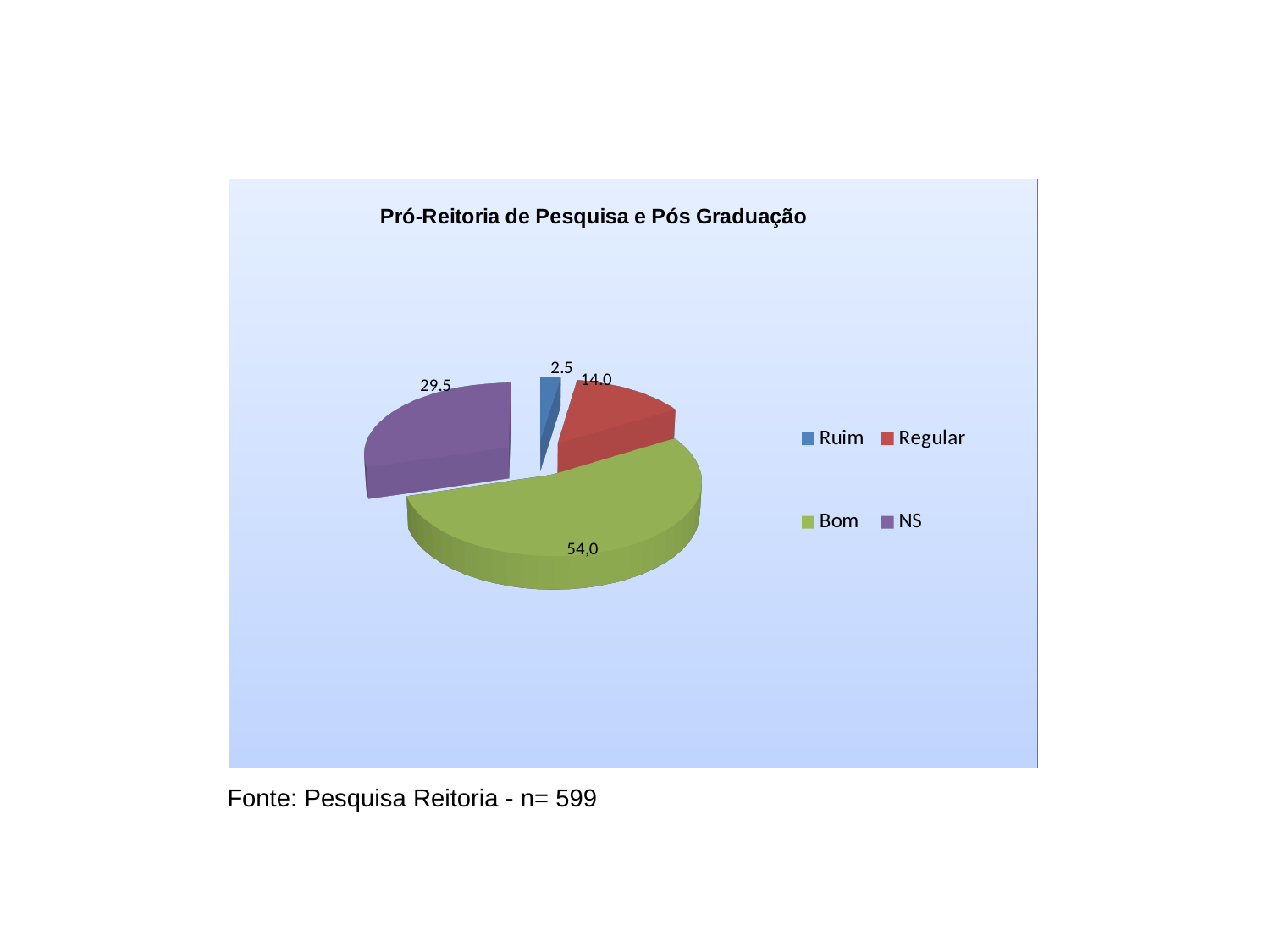
Which category has the smallest slice of the pie? Ruim What is the value shown for the Ruim slice? 2.5 Which category has the largest slice of the pie? Bom How many entries does the legend list? 4 Which slice is larger, NS or Regular? NS What is the value shown for the Regular slice? 14.0 How many slices does the pie chart have? 4 What is the value shown for the Bom slice? 54,0 What is the difference between the NS value and the Regular value? 15.5 What is the title of the chart? Pró-Reitoria de Pesquisa e Pós Graduação What kind of chart is shown on the slide? Pie chart What is the value shown for the NS slice? 29.5